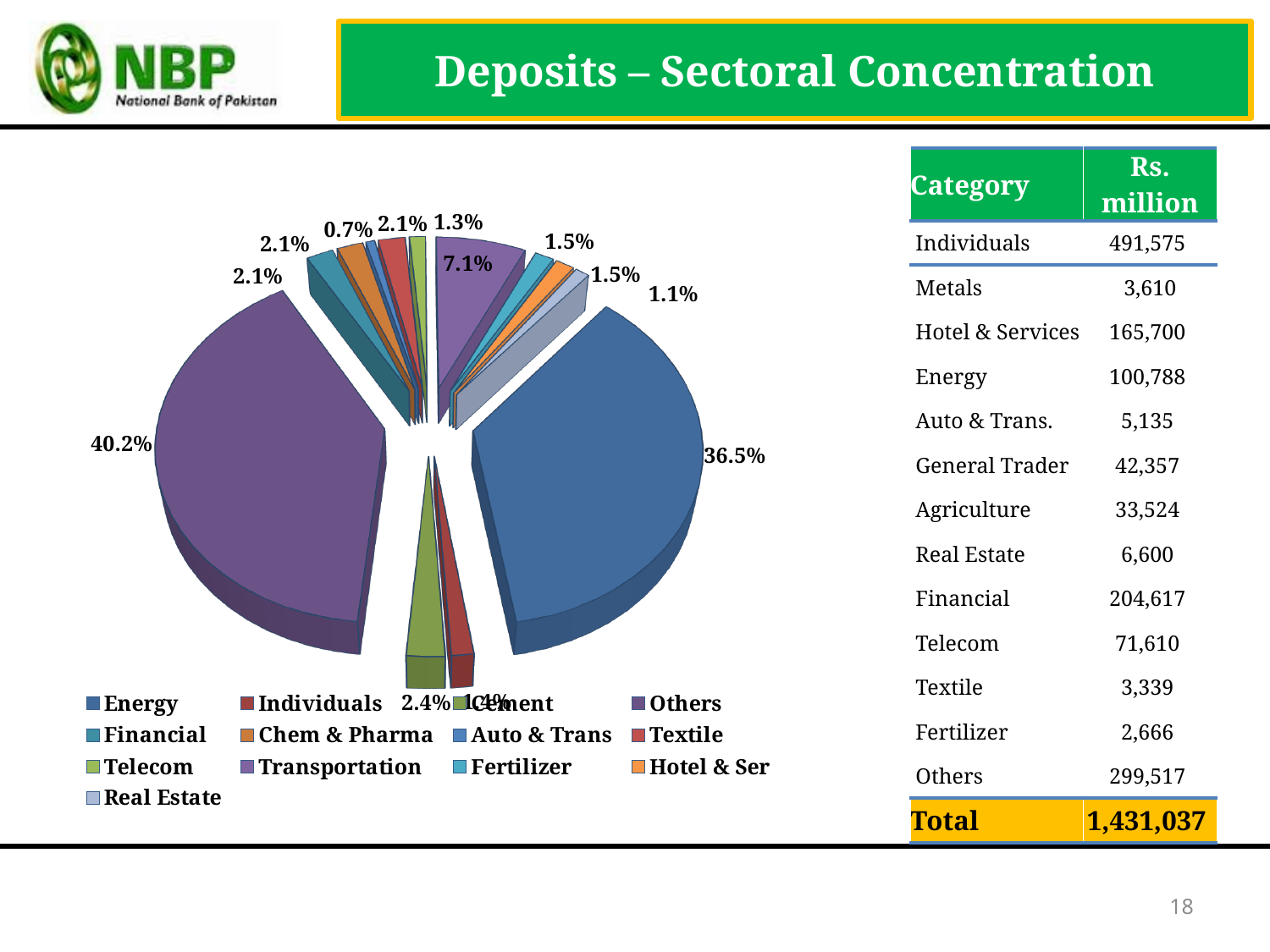
What is the percentage shown on the largest slice of the pie chart? 40.2% What colour is the largest (40.2%) slice of the pie chart? Purple Which is larger, the slice labelled 40.2% or the slice labelled 36.5%? 40.2% What is the combined share of the two largest slices (40.2% and 36.5%)? 76.7% How many entries does the pie chart's legend list? 13 What kind of chart is shown on the slide? Pie chart What is the percentage shown on the second-largest slice of the pie chart? 36.5% What is the difference in percentage points between the two largest slices (40.2% and 36.5%)? 3.7 percentage points What is the title of the slide containing the pie chart? Deposits – Sectoral Concentration What is the smallest percentage labelled on the pie chart? 0.7%